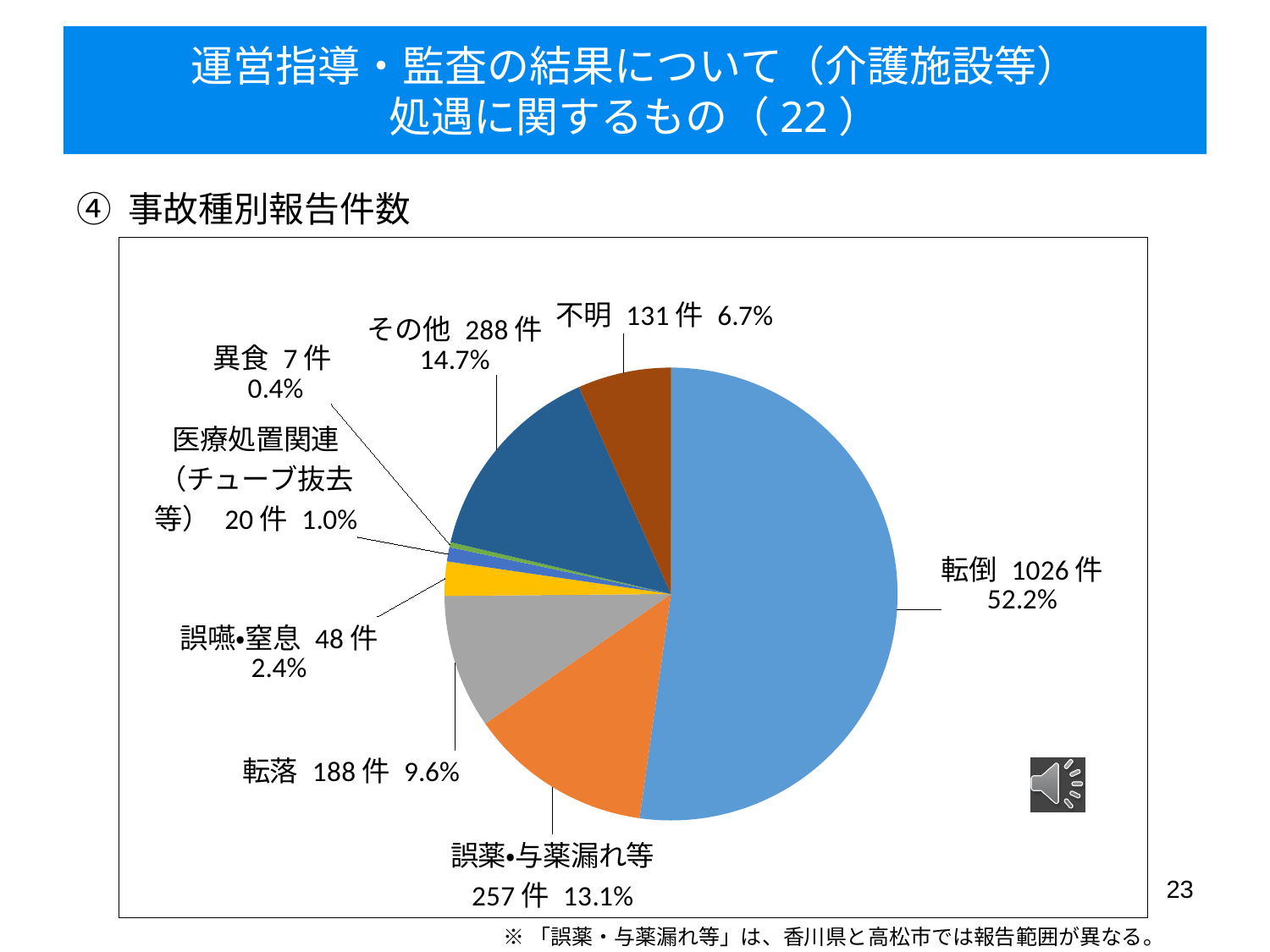
What kind of chart is shown on the slide? pie chart How many accident categories are shown in the pie chart? 8 What percentage is shown for その他? 14.7% Which accident type has the smallest number of reported cases? 異食 What is the difference in cases between その他 and 転落? 100 件 Which has more reported cases, 不明 or 誤嚥・窒息? 不明 What is the heading above the pie chart? ④ 事故種別報告件数 How many reported cases are shown for 転倒? 1026 件 Which accident type has the largest number of reported cases? 転倒 What share of the pie does 転倒 account for? 52.2% What is the total number of reported cases across all categories in the pie chart? 1965 件 How many cases are shown for 誤薬・与薬漏れ等? 257 件